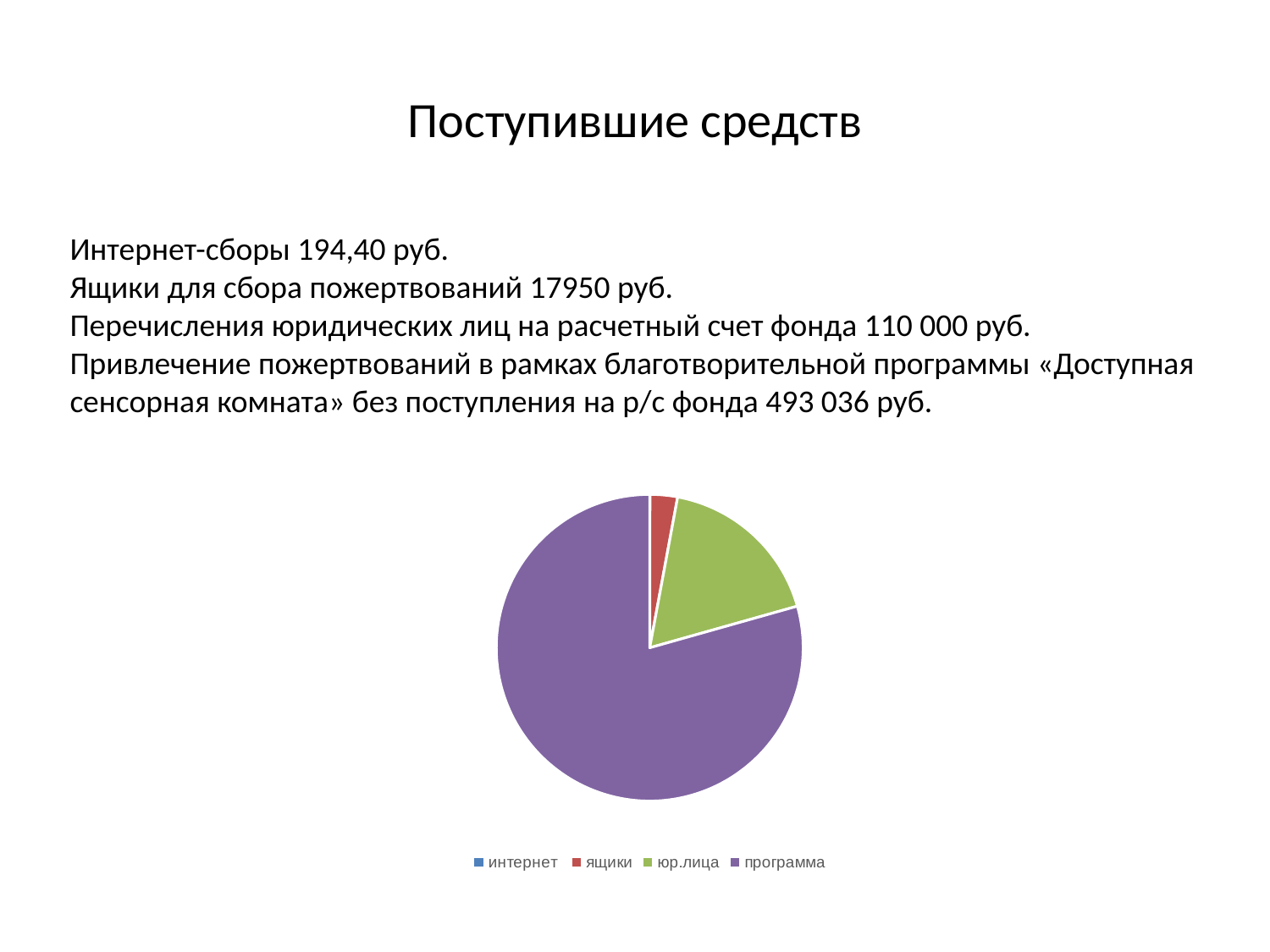
Which slice is larger in the pie chart, программа or юр.лица? программа How many categories does the pie chart's legend list? 4 Which category has the largest slice in the pie chart? программа Which of the visible slices in the pie chart is the smallest? ящики What colour is the программа slice in the pie chart? purple Does the программа slice take up more or less than half of the pie chart? more What kind of chart is shown on the slide? pie chart Which slice is larger in the pie chart, ящики or юр.лица? юр.лица What is the title of the slide containing the pie chart? Поступившие средств